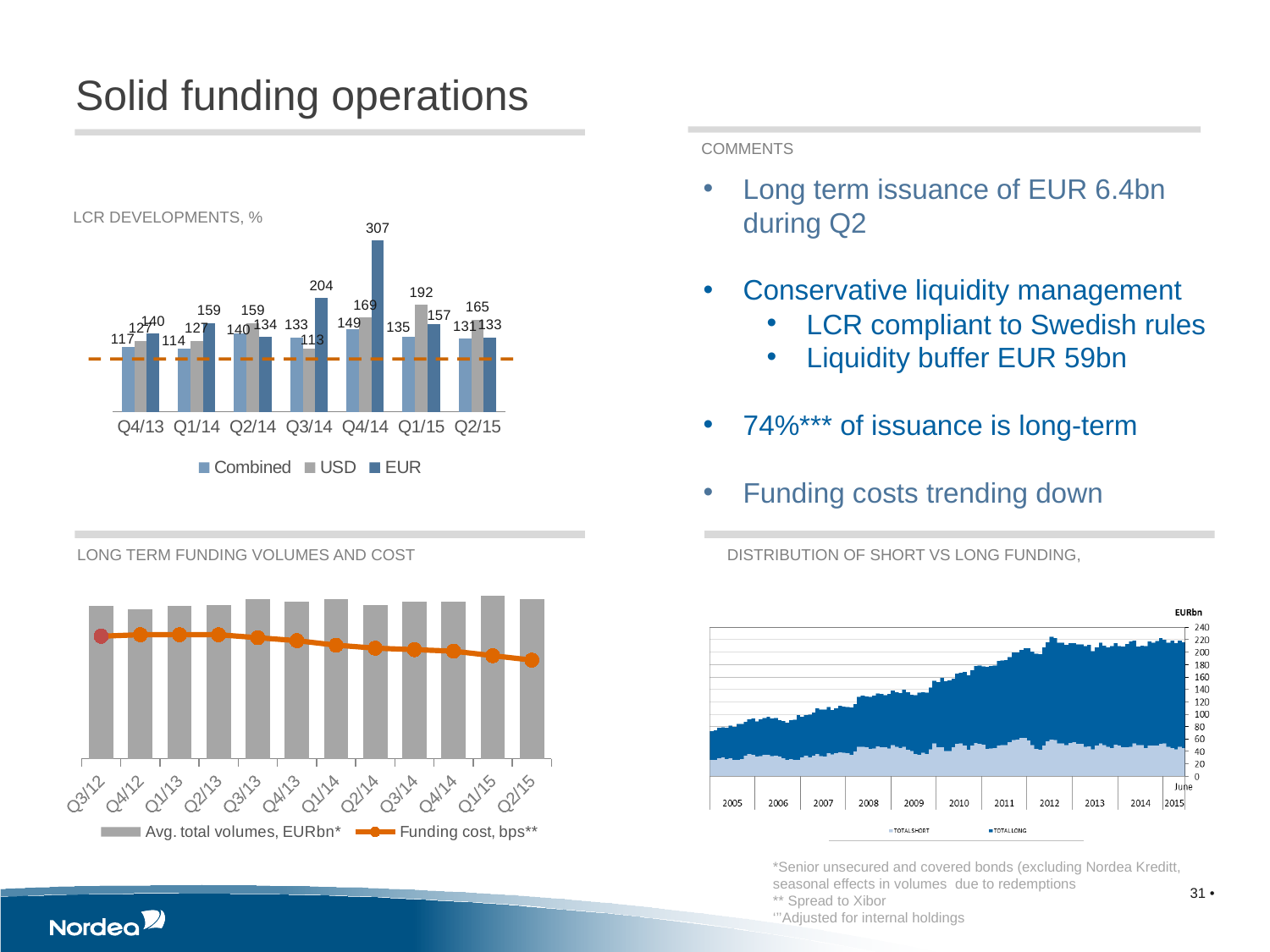
In the LCR DEVELOPMENTS chart, which quarter has the highest EUR value? Q4/14 In the LONG TERM FUNDING VOLUMES AND COST chart, how many quarters are shown on the x axis? 12 In the LCR DEVELOPMENTS chart, what is the Combined value for Q4/13? 117 In the LCR DEVELOPMENTS chart, how many series does the legend list? 3 In the LCR DEVELOPMENTS chart, how many quarters are shown on the x axis? 7 In the LCR DEVELOPMENTS chart, what is the Combined value for Q1/14? 114 In the LONG TERM FUNDING VOLUMES AND COST chart, does the funding cost line rise or fall from Q3/12 to Q2/15? fall In the DISTRIBUTION OF SHORT VS LONG FUNDING chart, is the total funding in 2015 greater or less than 200 EURbn? greater In the LCR DEVELOPMENTS chart, what is the EUR value for Q3/14? 204 In the DISTRIBUTION OF SHORT VS LONG FUNDING chart, what are the two series listed in the legend? TOTAL SHORT and TOTAL LONG In the LCR DEVELOPMENTS chart, what is the difference between the EUR value and the Combined value for Q4/14? 158 In the LCR DEVELOPMENTS chart, what is the EUR value for Q4/14? 307